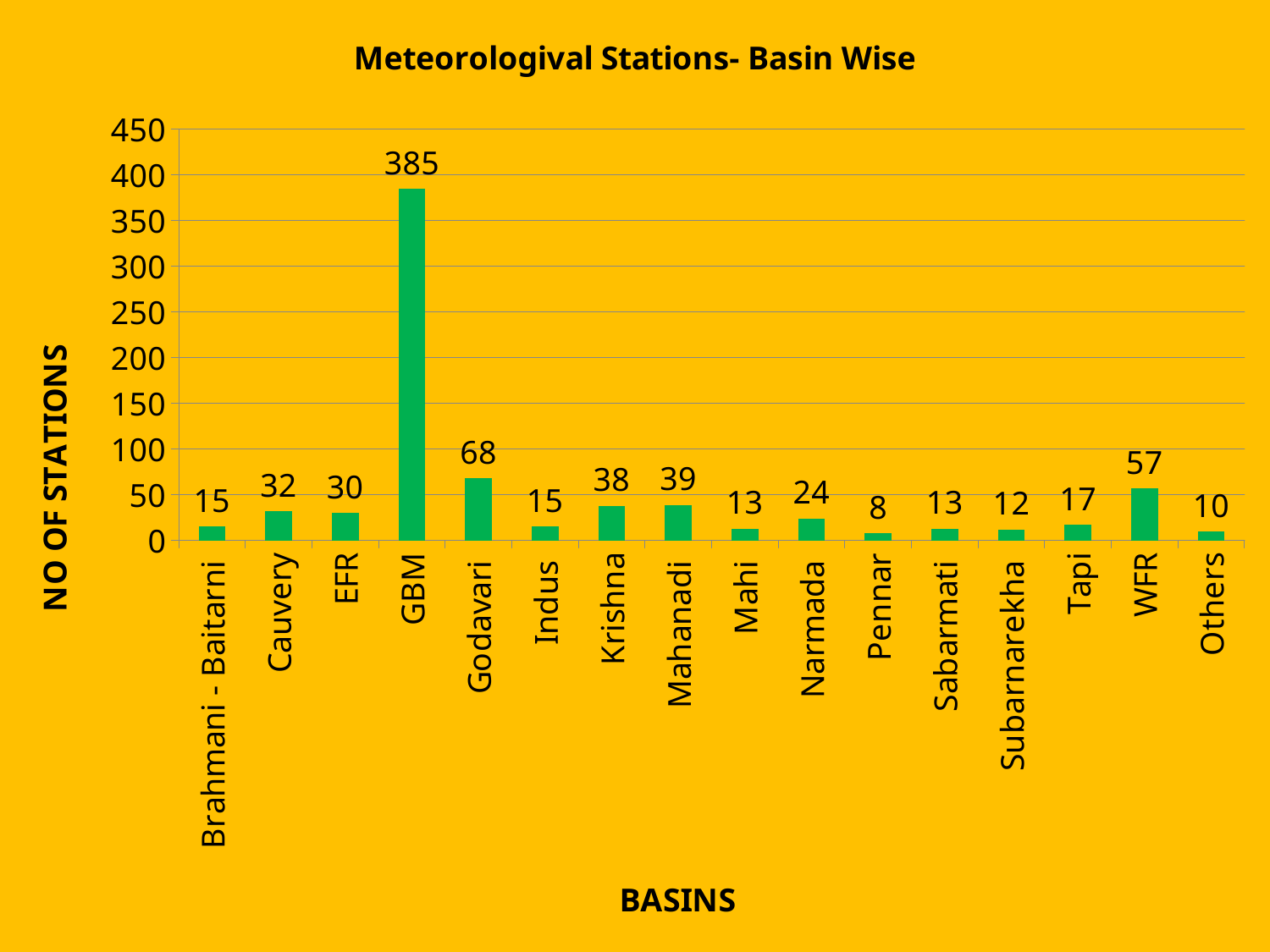
Which basin has the highest number of stations? GBM What is the difference in the number of stations between GBM and Godavari? 317 Which has more stations, Cauvery or Narmada? Cauvery What is the difference in the number of stations between Mahanadi and Krishna? 1 How many meteorological stations are in the GBM basin? 385 What type of chart is shown on the slide? Bar chart What is the title of the chart? Meteorologival Stations- Basin Wise Is the value for WFR greater or less than 50? greater How many stations does the WFR basin have? 57 How many basins are shown on the x axis? 16 Which basin has the lowest number of stations? Pennar What is the number of stations for the Godavari basin? 68